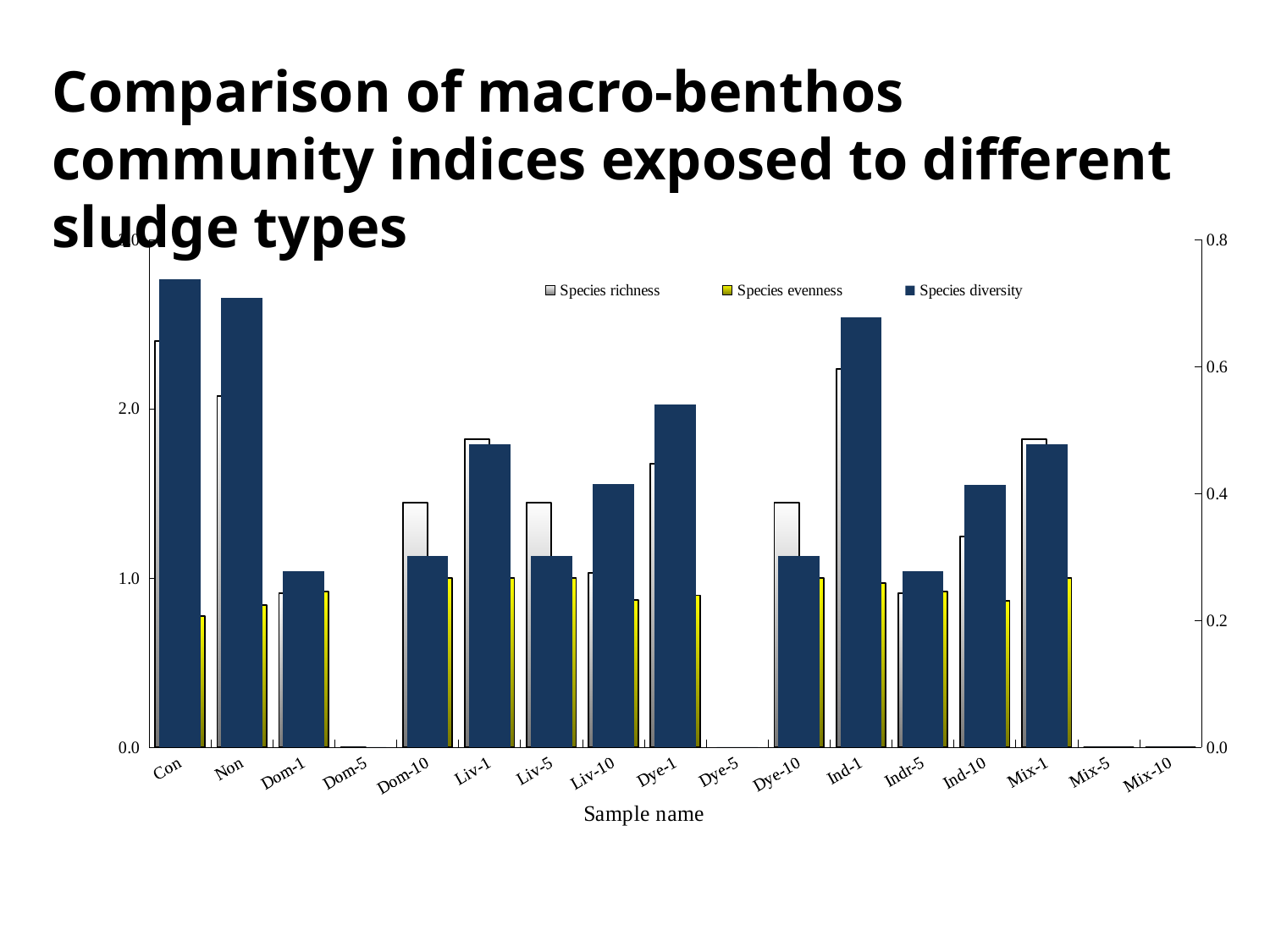
What kind of chart is shown on the slide? bar chart Is the Species richness bar for Ind-1 greater or less than 2.0 on the left axis? greater Is the Species richness bar for Dom-10 greater or less than 1.0 on the left axis? greater Which has the larger Species richness bar, Con or Non? Con How many sample categories are shown along the x axis? 17 Which sample has the highest Species diversity bar? Con Which has the larger Species richness bar, Liv-1 or Liv-5? Liv-1 Which sample has the highest Species richness bar? Con What is the title of the x axis? Sample name How many series does the legend list? 3 Which has the larger Species diversity bar, Ind-1 or Ind-10? Ind-1